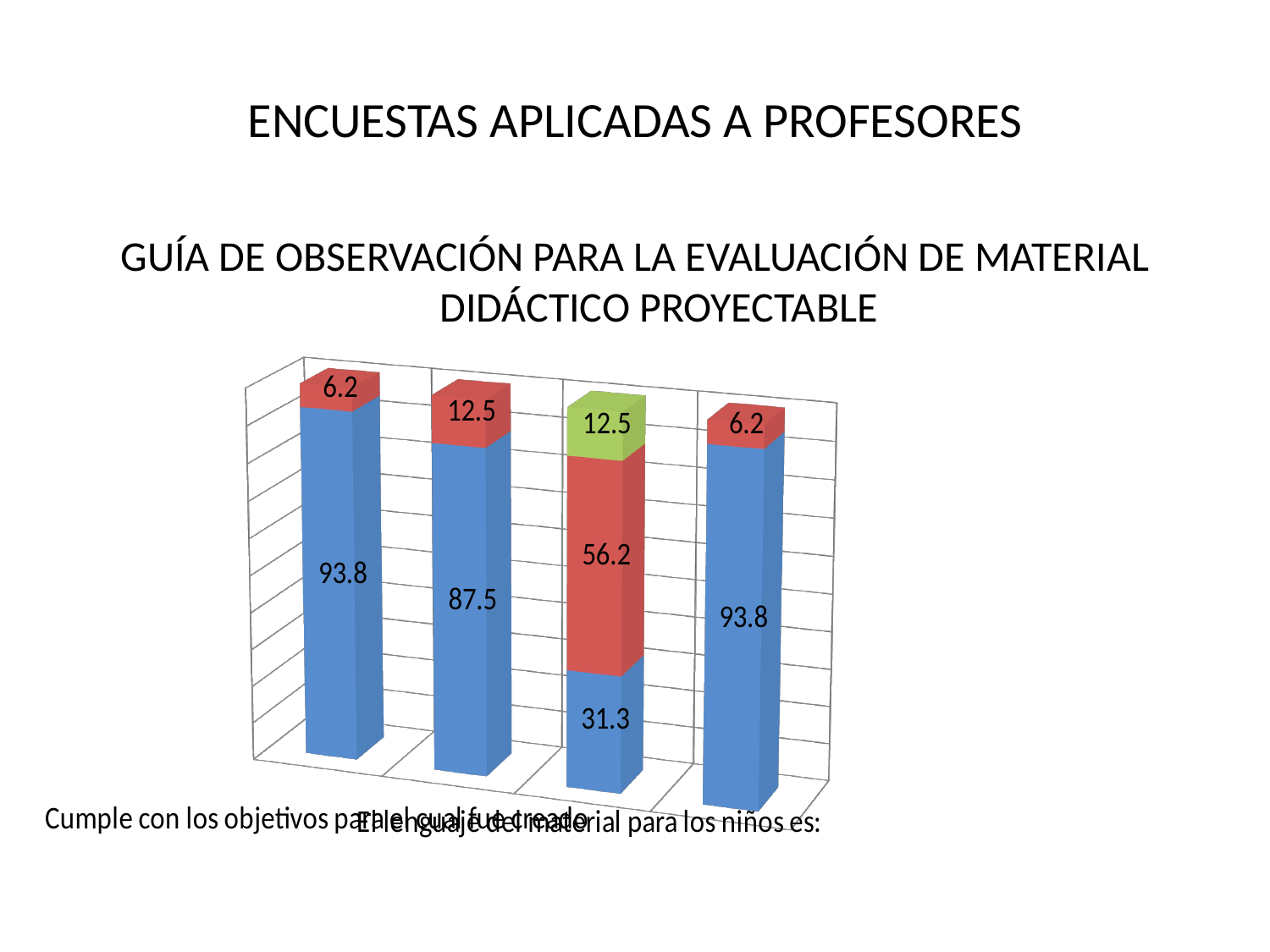
What kind of chart is shown on the slide? Stacked bar chart What is the difference between the blue segment of the first bar (93.8) and the blue segment of the second bar (87.5)? 6.3 What is the value of the green segment of the third bar from the left? 12.5 What is the value of the blue segment of the third bar from the left? 31.3 How many bars are plotted in the chart? 4 What is the value of the red segment of the fourth bar from the left? 6.2 Which bar has the smallest blue segment? The third bar from the left What is the value of the blue segment of the first bar from the left? 93.8 What is the title of the chart? GUÍA DE OBSERVACIÓN PARA LA EVALUACIÓN DE MATERIAL DIDÁCTICO PROYECTABLE What is the value of the red segment of the third bar from the left? 56.2 What is the value of the red segment of the second bar from the left? 12.5 Which is larger: the red segment of the second bar or the red segment of the fourth bar? The red segment of the second bar